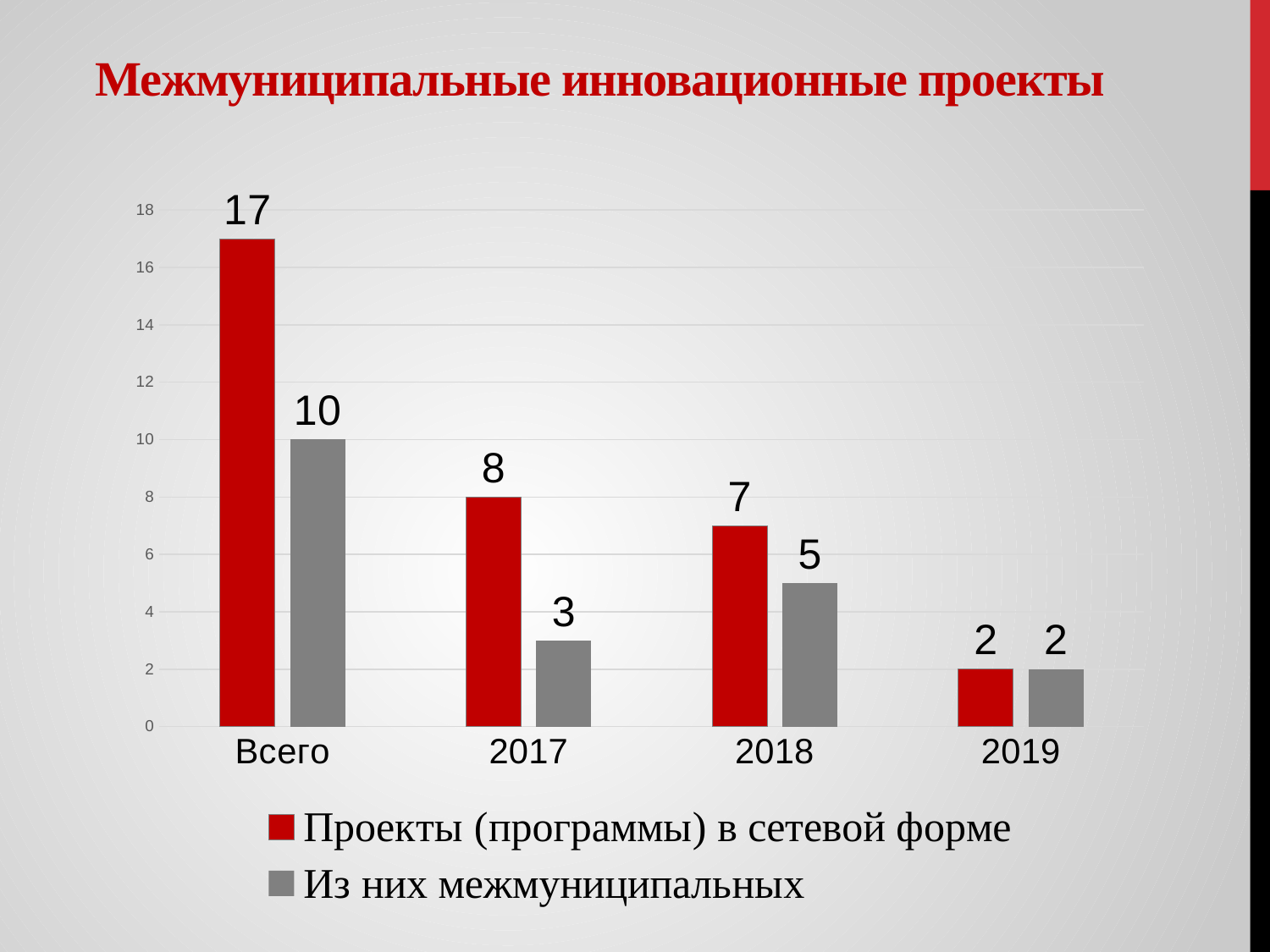
Which year has the lowest value for "Из них межмуниципальных"? 2019 Which is larger in 2018: "Проекты (программы) в сетевой форме" or "Из них межмуниципальных"? Проекты (программы) в сетевой форме What is the value for "Проекты (программы) в сетевой форме" in the "Всего" category? 17 What is the value for "Проекты (программы) в сетевой форме" in 2017? 8 Which category has the highest value for "Проекты (программы) в сетевой форме"? Всего What is the difference between "Проекты (программы) в сетевой форме" and "Из них межмуниципальных" in 2017? 5 What is the value for "Из них межмуниципальных" in 2018? 5 How many series does the legend list? 2 What colour are the bars for "Из них межмуниципальных"? Grey What kind of chart is shown on the slide? Bar chart Do the values for "Проекты (программы) в сетевой форме" rise or fall from 2017 to 2019? Fall How many categories are shown on the x axis? 4